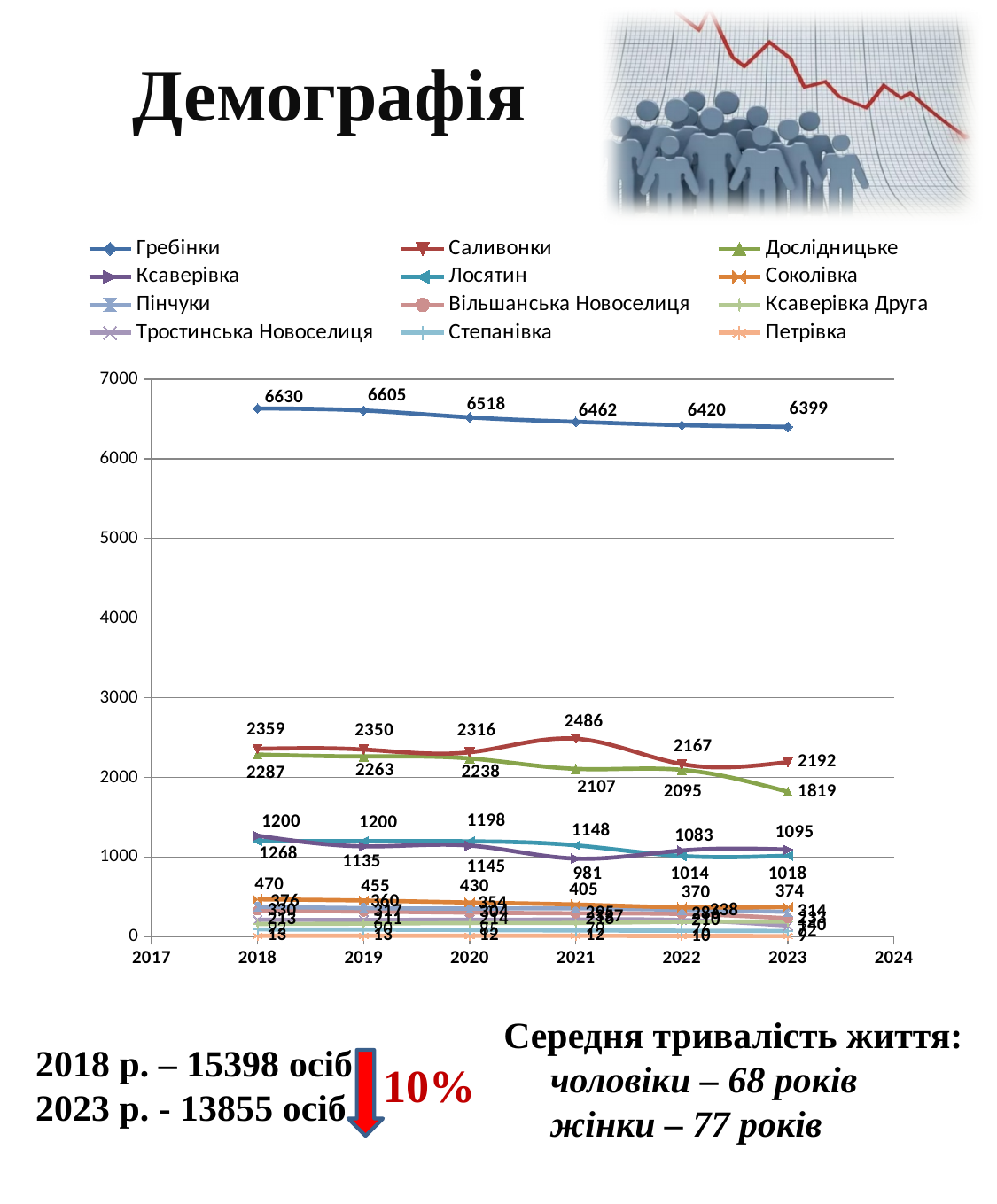
What is the value for Дослідницьке in 2023? 1819 In which year does Саливонки reach its highest value? 2021 What is the value for Гребінки in 2018? 6630 What type of chart is shown on the slide? line chart Does the value for Гребінки rise or fall from 2018 to 2023? fall By how much did the value for Гребінки change from 2018 to 2023? 231 What is the value for Саливонки in 2021? 2486 How many series does the legend list? 12 Which series has the highest values across all years? Гребінки Which is larger in 2018: Саливонки or Дослідницьке? Саливонки What is the value for Гребінки in 2023? 6399 What is the value for Соколівка in 2018? 470